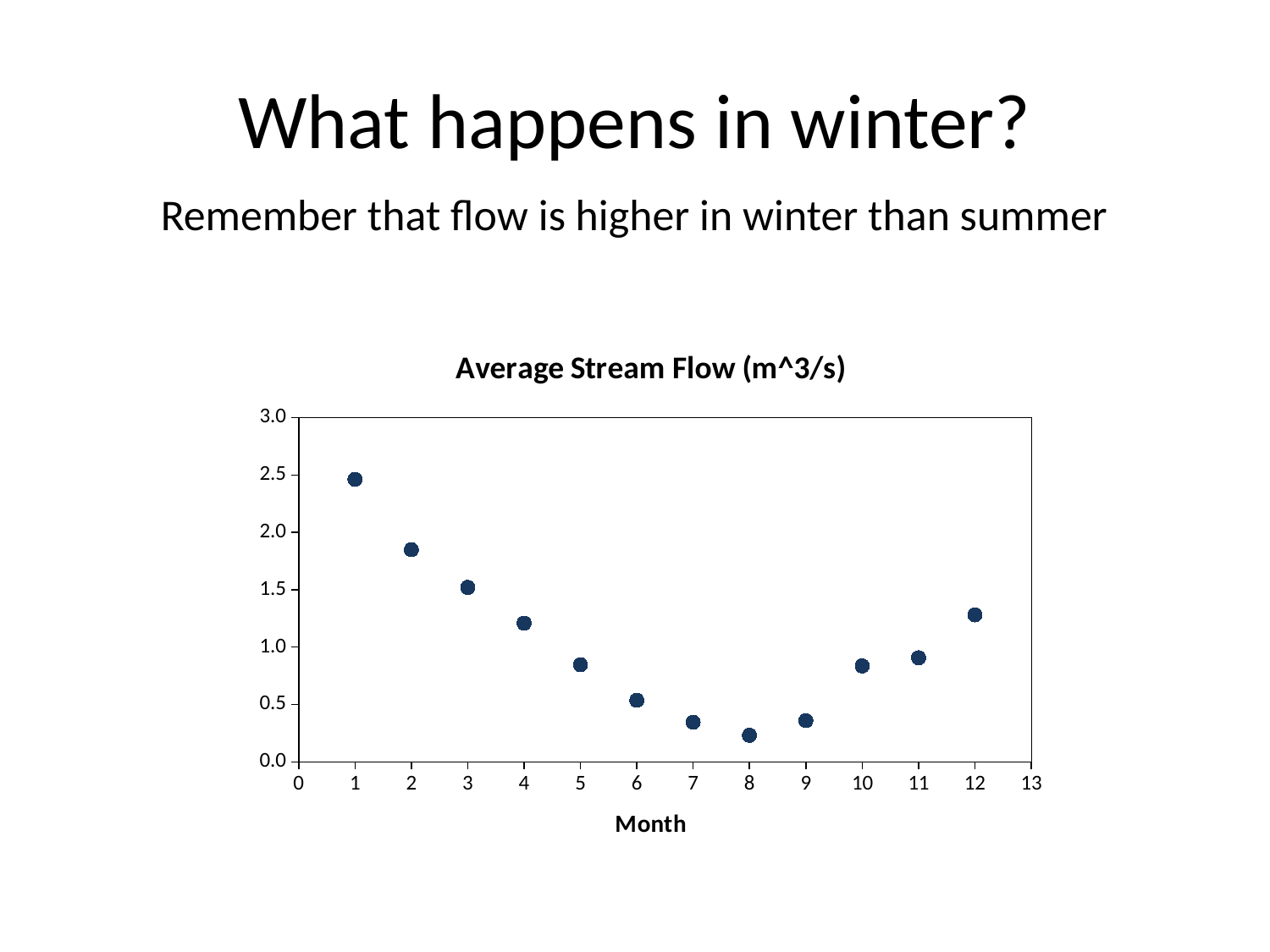
Is the average stream flow for month 1 greater or less than 2.0? greater What is the title of the chart? Average Stream Flow (m^3/s) Which has a higher average stream flow, month 1 or month 12? month 1 How many data points are plotted in the Average Stream Flow chart? 12 What kind of chart is shown on the slide? scatter plot Does the average stream flow rise or fall from month 1 to month 8? fall Which month has the lowest average stream flow? 8 Is the average stream flow for month 12 greater or less than 1.0? greater Which has a higher average stream flow, month 2 or month 11? month 2 Is the average stream flow for month 10 greater or less than 1.0? less Which month has the highest average stream flow? 1